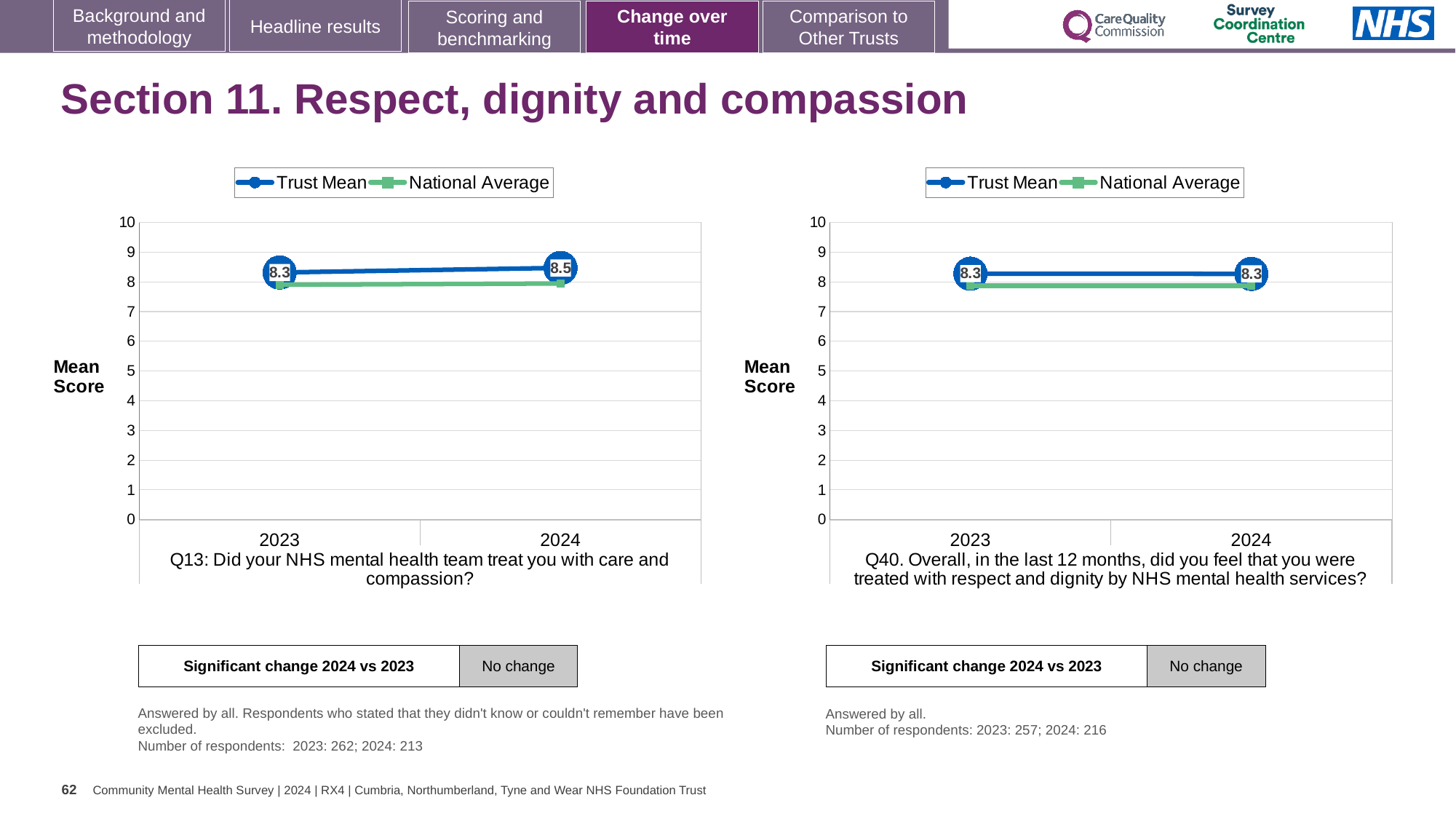
What kind of chart is the left chart (Q13)? line chart In the left chart (Q13), does the Trust Mean rise, fall or stay the same from 2023 to 2024? rise In the right chart (Q40), does the Trust Mean rise, fall or stay the same from 2023 to 2024? stay the same In the right chart (Q40), what is the Trust Mean score for 2024? 8.3 How many years are shown on the x axis of the left chart (Q13)? 2 In the left chart (Q13), which is larger in 2024, the Trust Mean or the National Average? Trust Mean In the right chart (Q40), is the National Average for 2023 greater or less than 7? greater How many series does the legend of the right chart (Q40) list? 2 What is the y-axis label of the right chart (Q40)? Mean Score In the left chart (Q13), what is the Trust Mean score for 2023? 8.3 In the left chart (Q13), by how much did the Trust Mean change from 2023 to 2024? 0.2 In the left chart (Q13), what is the Trust Mean score for 2024? 8.5